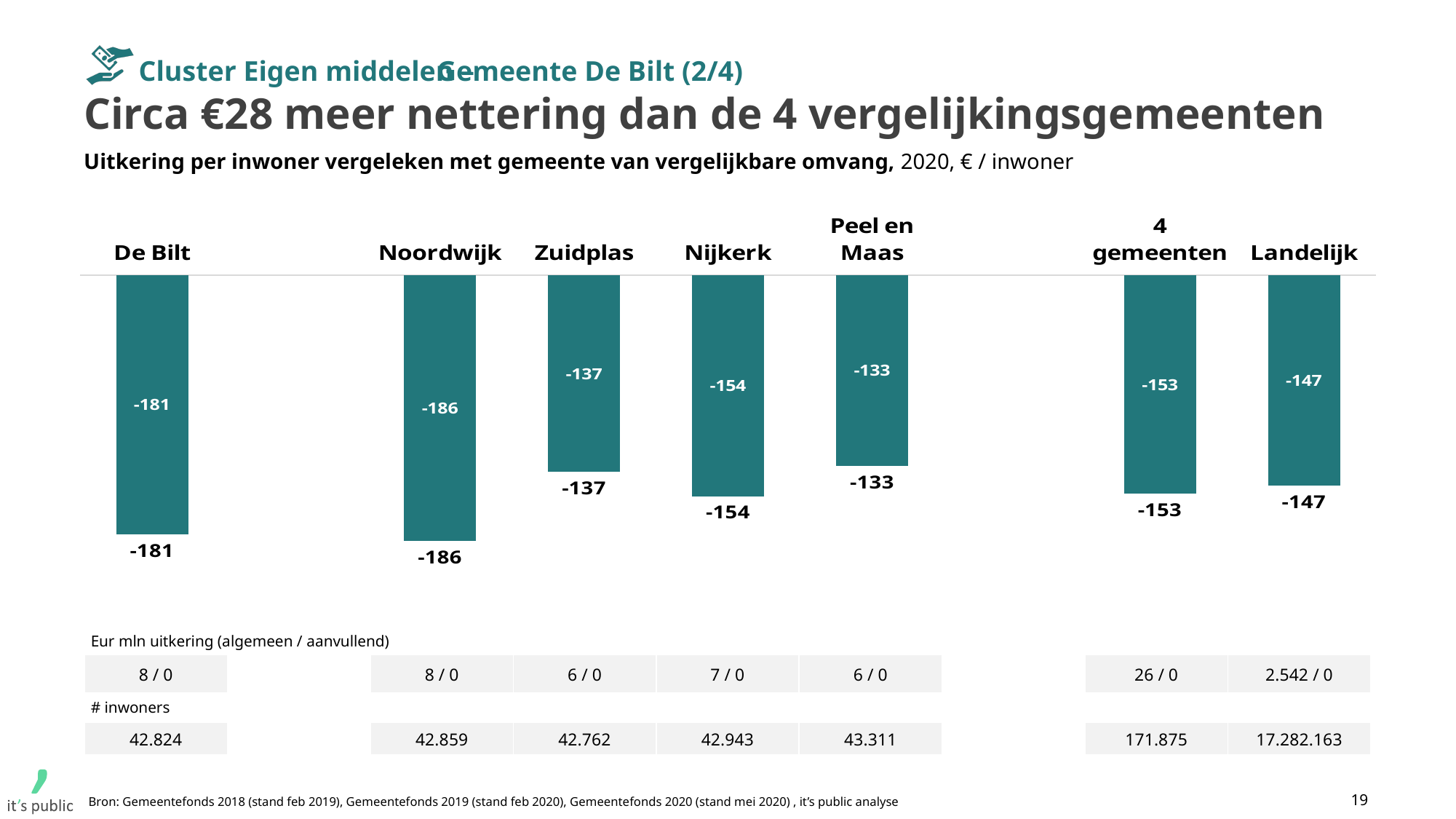
What is the value for Peel en Maas in the chart? -133 What is the value for De Bilt in the chart? -181 What kind of chart is shown on the slide? Bar chart What is the value for Landelijk in the chart? -147 How many categories are shown in the chart? 7 Which category has the most negative value (the longest bar) in the chart? Noordwijk What is the value for Noordwijk in the chart? -186 What unit is stated in the chart subtitle for the values? € / inwoner Which category has the highest (least negative) value in the chart? Peel en Maas Which has the more negative value, Nijkerk or Zuidplas? Nijkerk What is the difference between the values for De Bilt and 4 gemeenten? 28 What is the difference between the values for Noordwijk and Zuidplas? 49